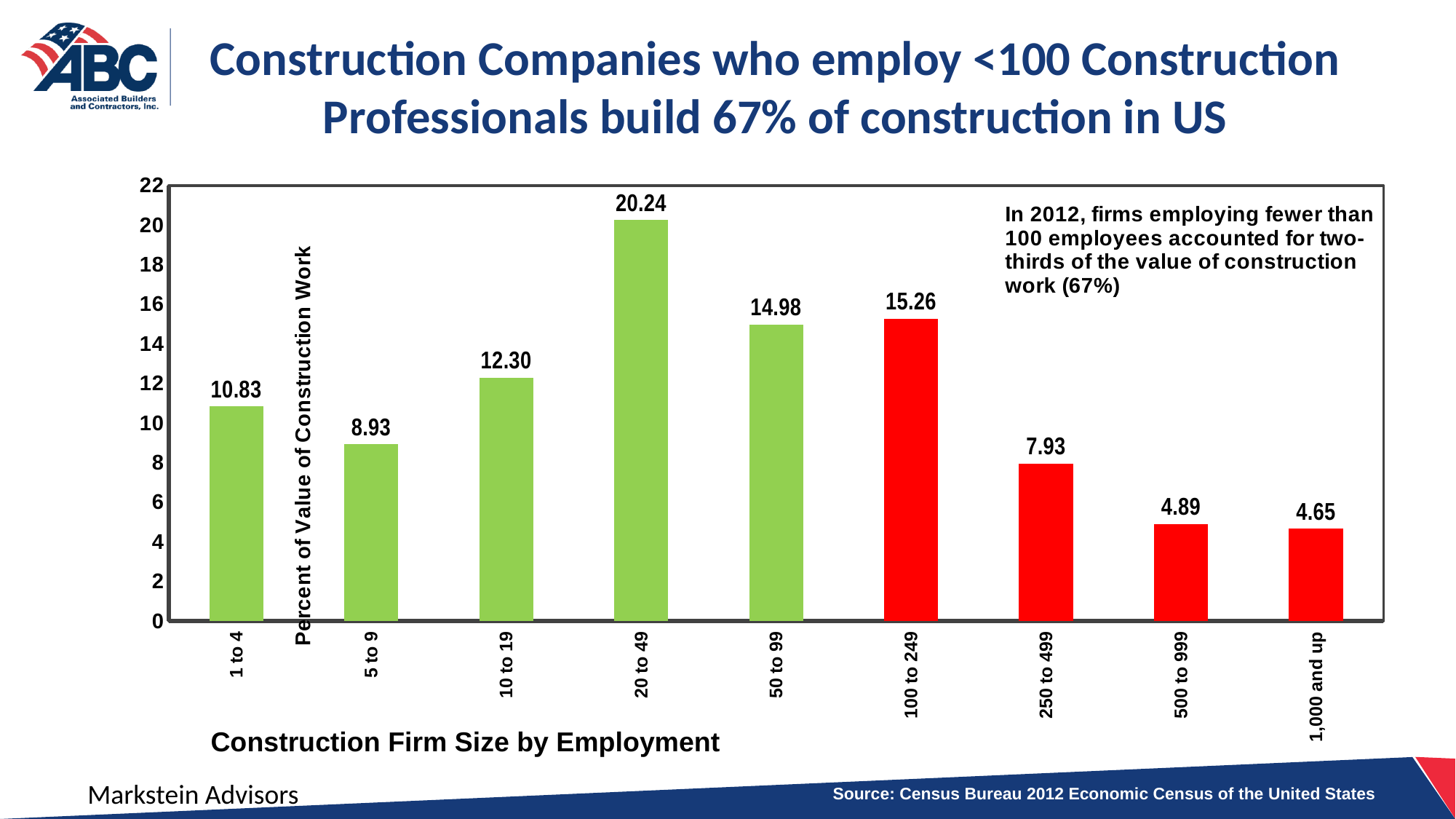
What is the total of the values for the 500 to 999 and 1,000 and up categories? 9.54 Which is larger, the value for 1 to 4 or the value for 5 to 9? 1 to 4 What is the value shown for firms with 100 to 249 employees? 15.26 What is the value shown for the 1,000 and up firm size category? 4.65 What is the label of the x axis? Construction Firm Size by Employment Is the value for 250 to 499 greater or less than 10? less Which firm size category has the highest percent of value of construction work? 20 to 49 What is the difference between the values for the 20 to 49 and 50 to 99 categories? 5.26 Which firm size category has the lowest percent of value of construction work? 1,000 and up How many firm size categories are shown on the x axis? 9 What kind of chart is shown on the slide? Bar chart What is the percent of value of construction work for firms with 20 to 49 employees? 20.24